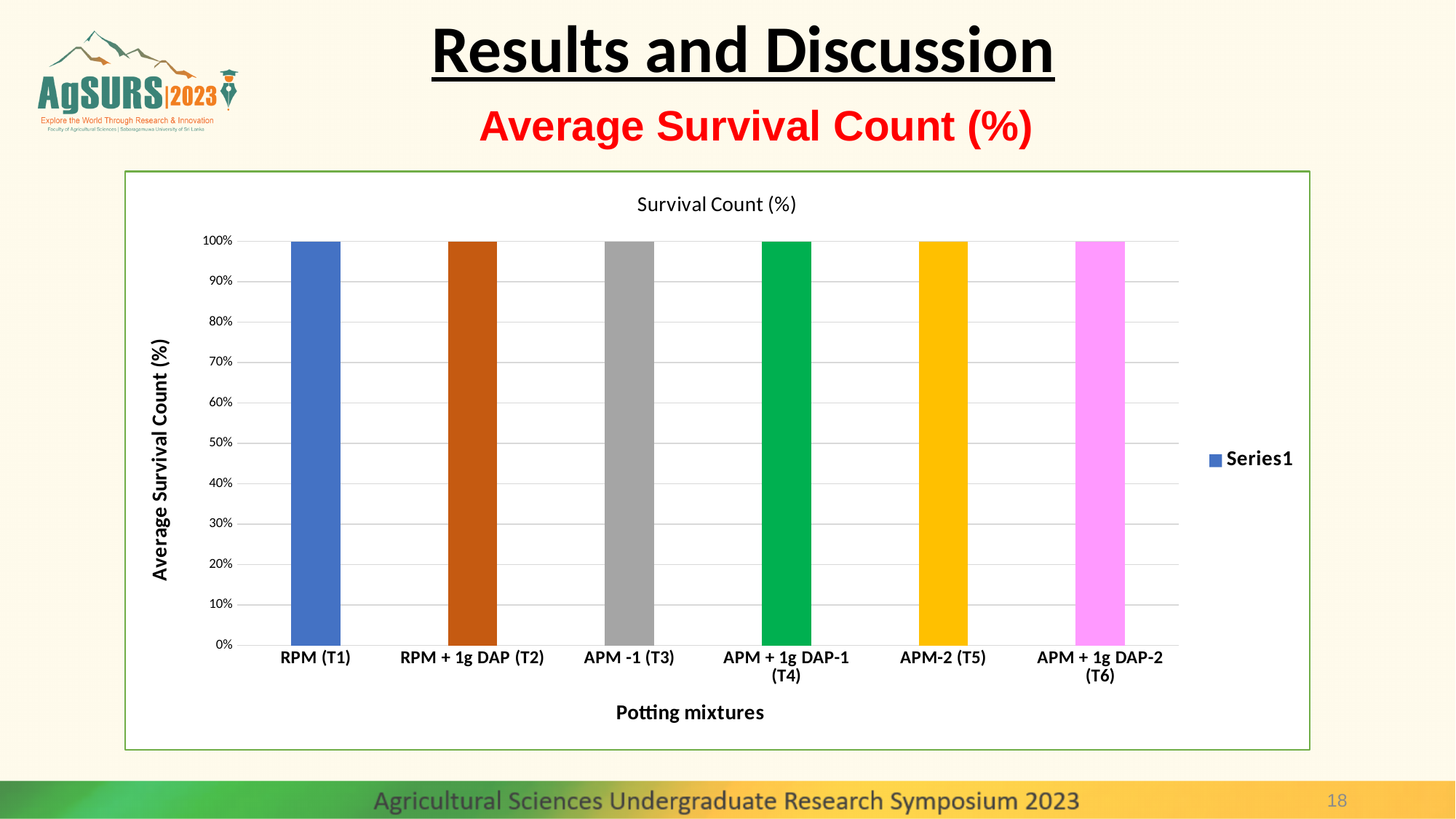
What is the label of the x axis? Potting mixtures What kind of chart is shown on the slide? bar chart Is the value for APM -1 (T3) greater or less than 50%? greater How many potting mixtures (categories) are plotted on the x axis? 6 What is the title of the chart? Survival Count (%) How many series does the legend list? 1 Is the value for RPM + 1g DAP (T2) greater or less than 90%? greater What is the average survival count for APM + 1g DAP-2 (T6)? 100%